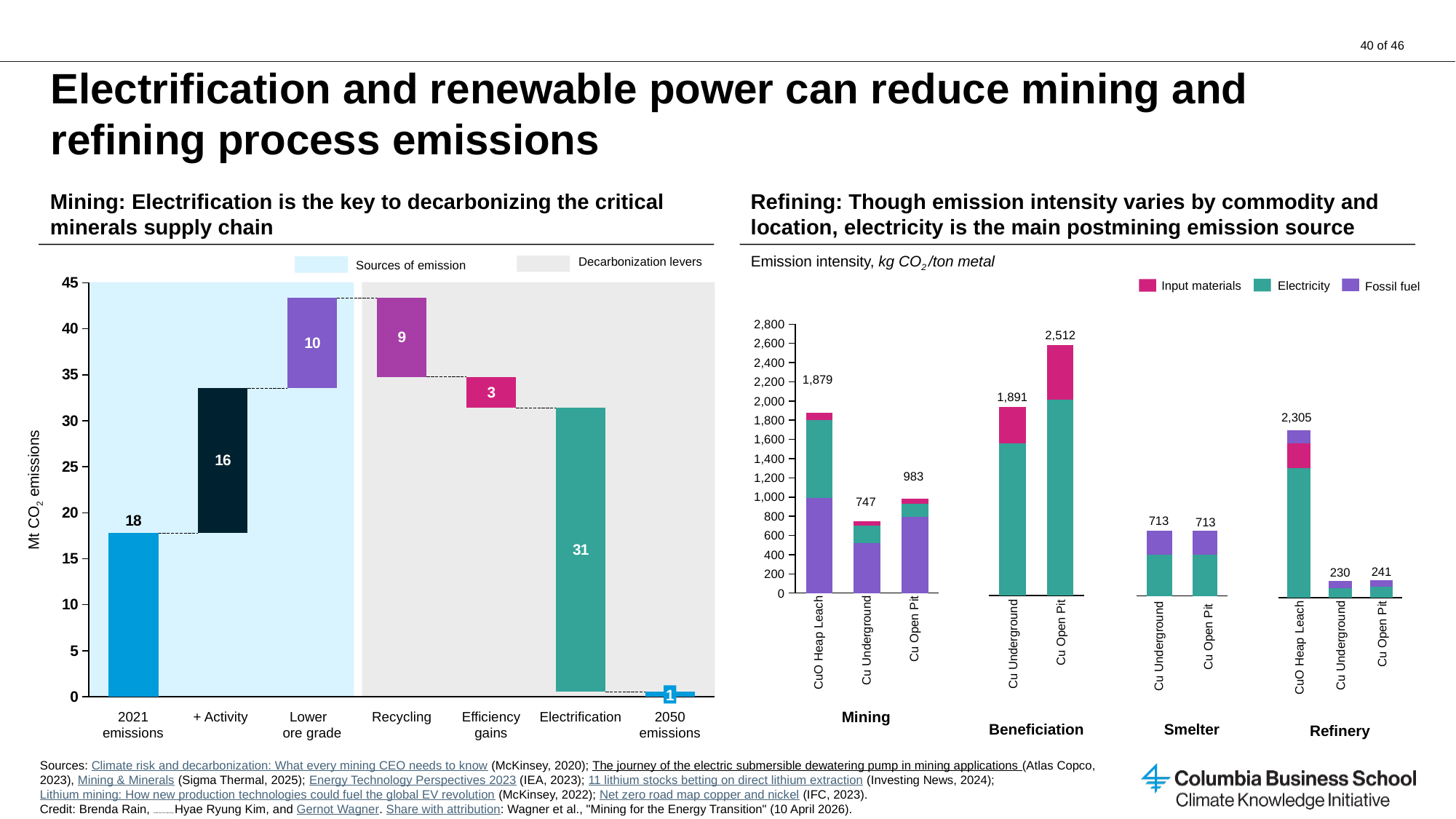
In the right chart (Refining emission intensity), which bar has the highest total? Cu Open Pit (Beneficiation) In the left chart (Mining), what is the value for Electrification? 31 In the left chart (Mining), what is the value for 2021 emissions? 18 In the right chart (Refining emission intensity), how many series does the legend list? 3 In the right chart (Refining emission intensity), what is the total for CuO Heap Leach under Refinery? 2,305 In the right chart (Refining emission intensity), which bar has the lowest total? Cu Underground (Refinery) In the left chart (Mining), what is the value for 2050 emissions? 1 In the right chart (Refining emission intensity), what is the difference between the Cu Open Pit total and the Cu Underground total under Mining? 236 In the left chart (Mining), which is larger, the Recycling value or the Efficiency gains value? Recycling In the left chart (Mining), how many categories are shown on the x axis? 7 In the right chart (Refining emission intensity), what is the total for Cu Open Pit under Beneficiation? 2,512 In the left chart (Mining), what is the difference between the + Activity value and the Lower ore grade value? 6